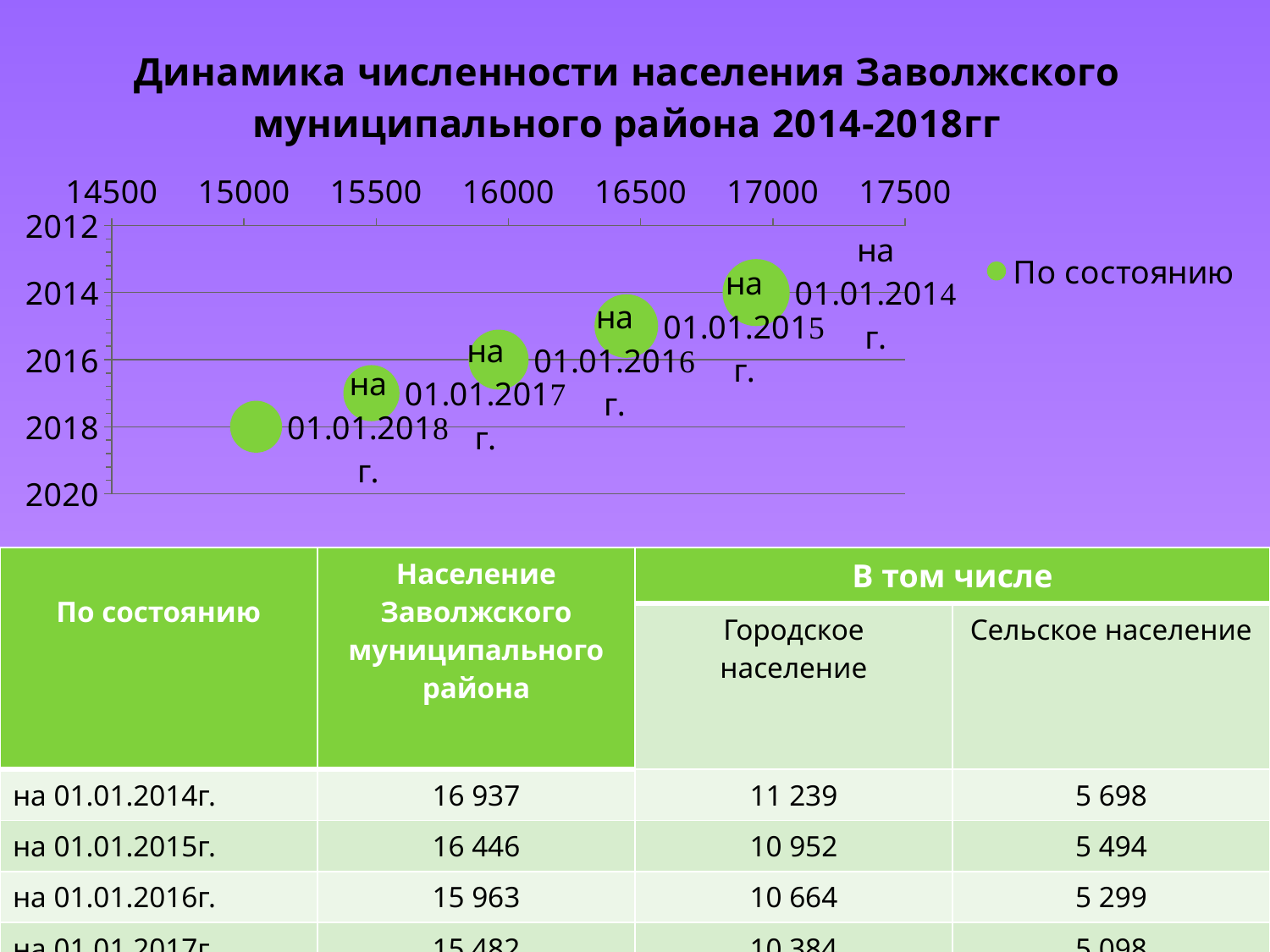
What is the legend entry of the chart? По состоянию Which date has the lowest population value on the chart? на 01.01.2018 г. Is the value for на 01.01.2018 г. greater or less than 15500? less Does the population rise or fall from 01.01.2014 to 01.01.2018 on the chart? fall According to the table, what is the population of the Zavolzhsky municipal district as of 01.01.2014? 16 937 Is the value for на 01.01.2016 г. greater or less than 15500? greater How many series does the chart legend list? 1 How many data points (bubbles) are plotted on the chart? 5 Which is larger, the value for на 01.01.2015 г. or the value for на 01.01.2017 г.? на 01.01.2015 г. Is the value for на 01.01.2014 г. greater or less than 16500? greater Which date has the highest population value on the chart? на 01.01.2014 г. What kind of chart is shown on the slide? bubble chart